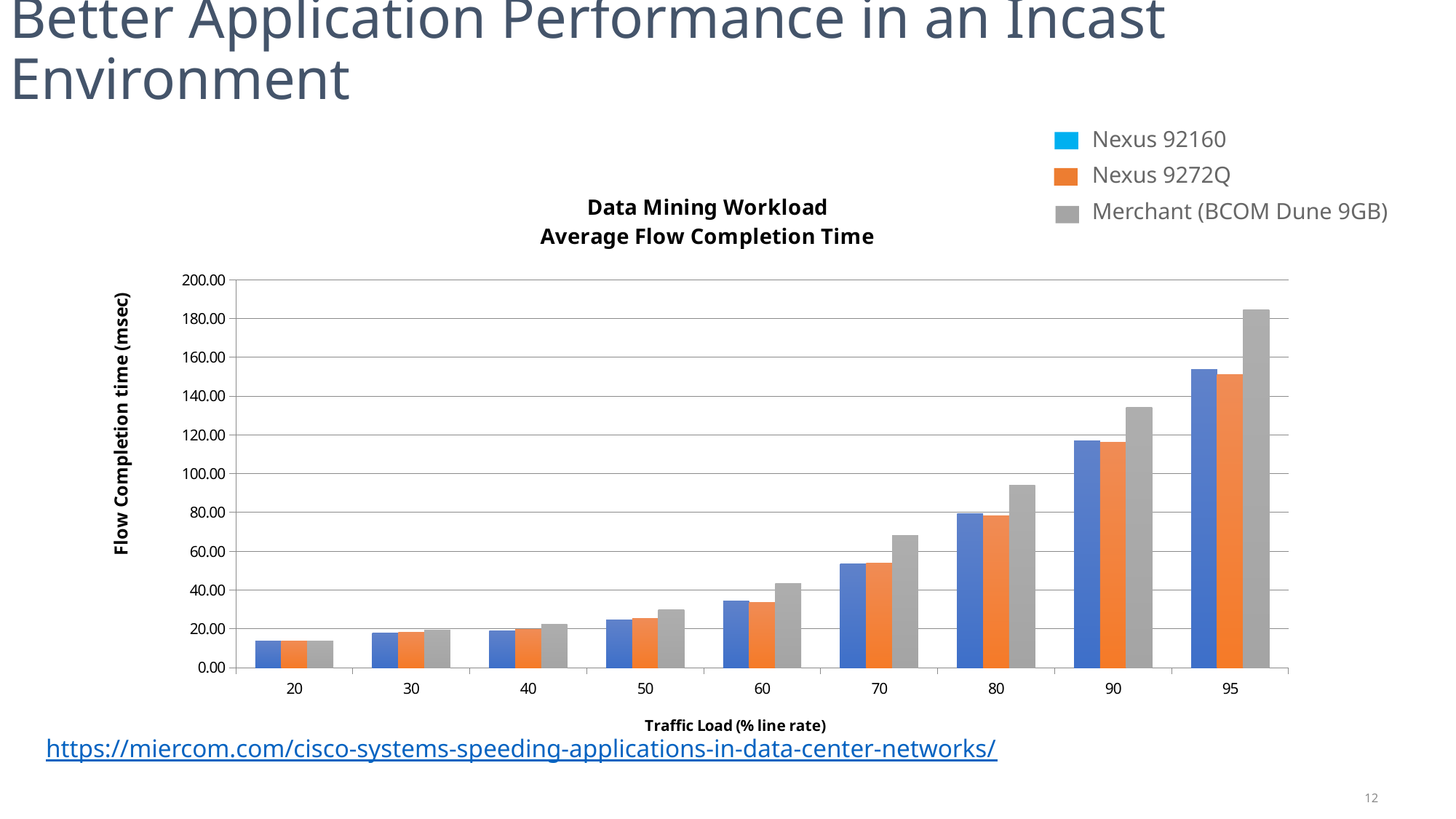
Is the value for Nexus 92160 at traffic load 80 greater or less than 100.00? less What kind of chart is shown on the slide? bar chart How many traffic load categories are shown on the x axis? 9 At which traffic load is the Merchant (BCOM Dune 9GB) flow completion time lowest? 20 At a traffic load of 90, which is larger: the value for Merchant (BCOM Dune 9GB) or the value for Nexus 92160? Merchant (BCOM Dune 9GB) How many series does the legend list? 3 Is the value for Merchant (BCOM Dune 9GB) at traffic load 90 greater or less than 120.00? greater Which series has the highest flow completion time at a traffic load of 95? Merchant (BCOM Dune 9GB) Do the flow completion times rise or fall as traffic load increases along the x axis? rise What is the label of the y axis? Flow Completion time (msec) Is the value for Nexus 92160 at traffic load 60 greater or less than 40.00? less